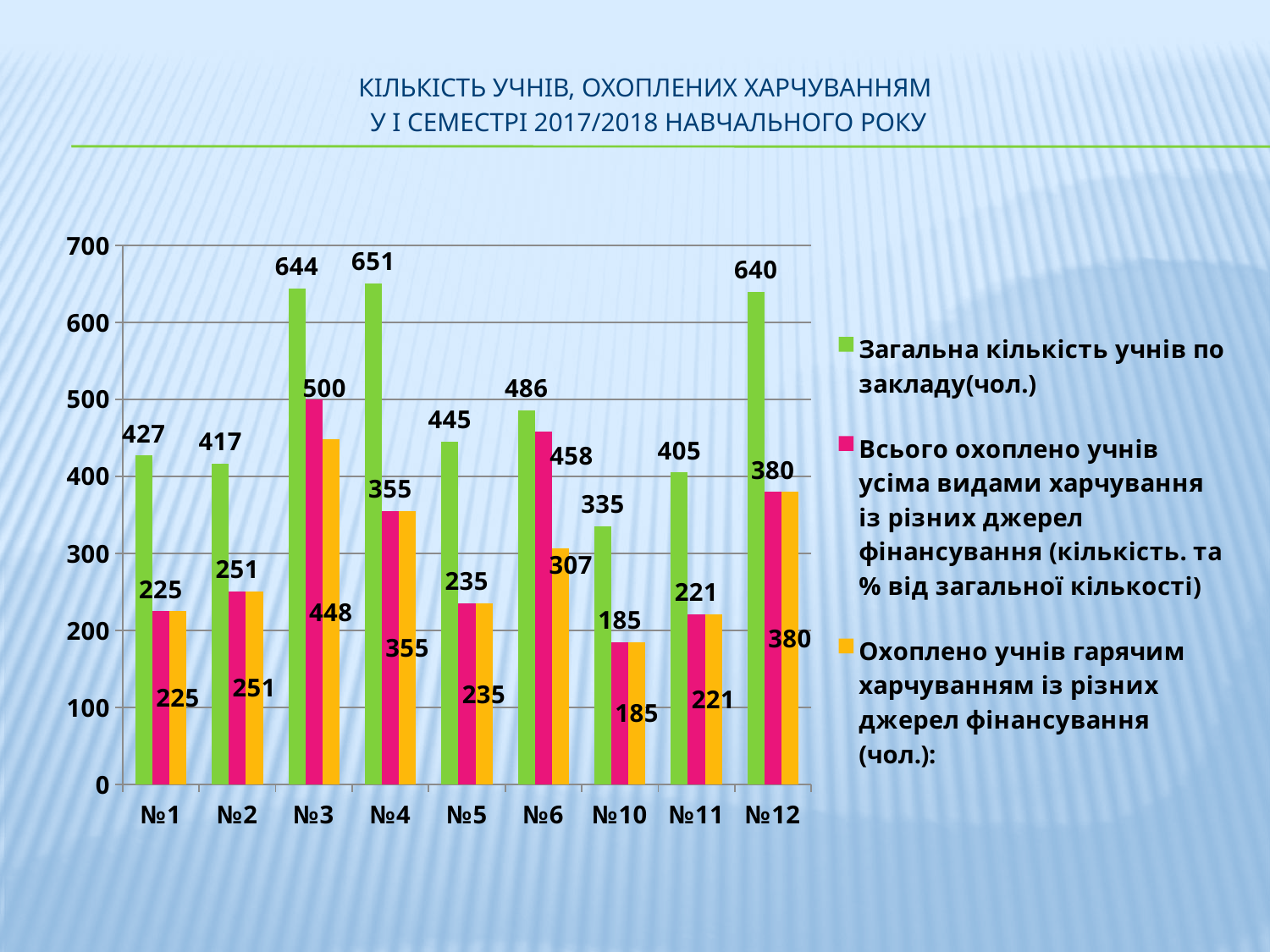
What is the difference between the total number of students and the number covered by all types of feeding at №4? 296 Which is larger: the total number of students at №1 or at №2? №1 What is the value of 'Всього охоплено учнів усіма видами харчування' for №12? 380 Which institution has the lowest number of students covered by all types of feeding (pink series)? №10 What type of chart is shown on the slide? Bar chart How many students are covered by hot meals (Охоплено учнів гарячим харчуванням) at №6? 307 Which institution has the highest total number of students (green series)? №4 What is the total number of students (Загальна кількість учнів по закладу) for №3? 644 What is the difference between the number covered by all types of feeding and the number covered by hot meals at №3? 52 Which colour represents 'Загальна кількість учнів по закладу(чол.)' in the legend? Green How many institutions (categories) are shown on the x axis? 9 How many series does the legend list? 3